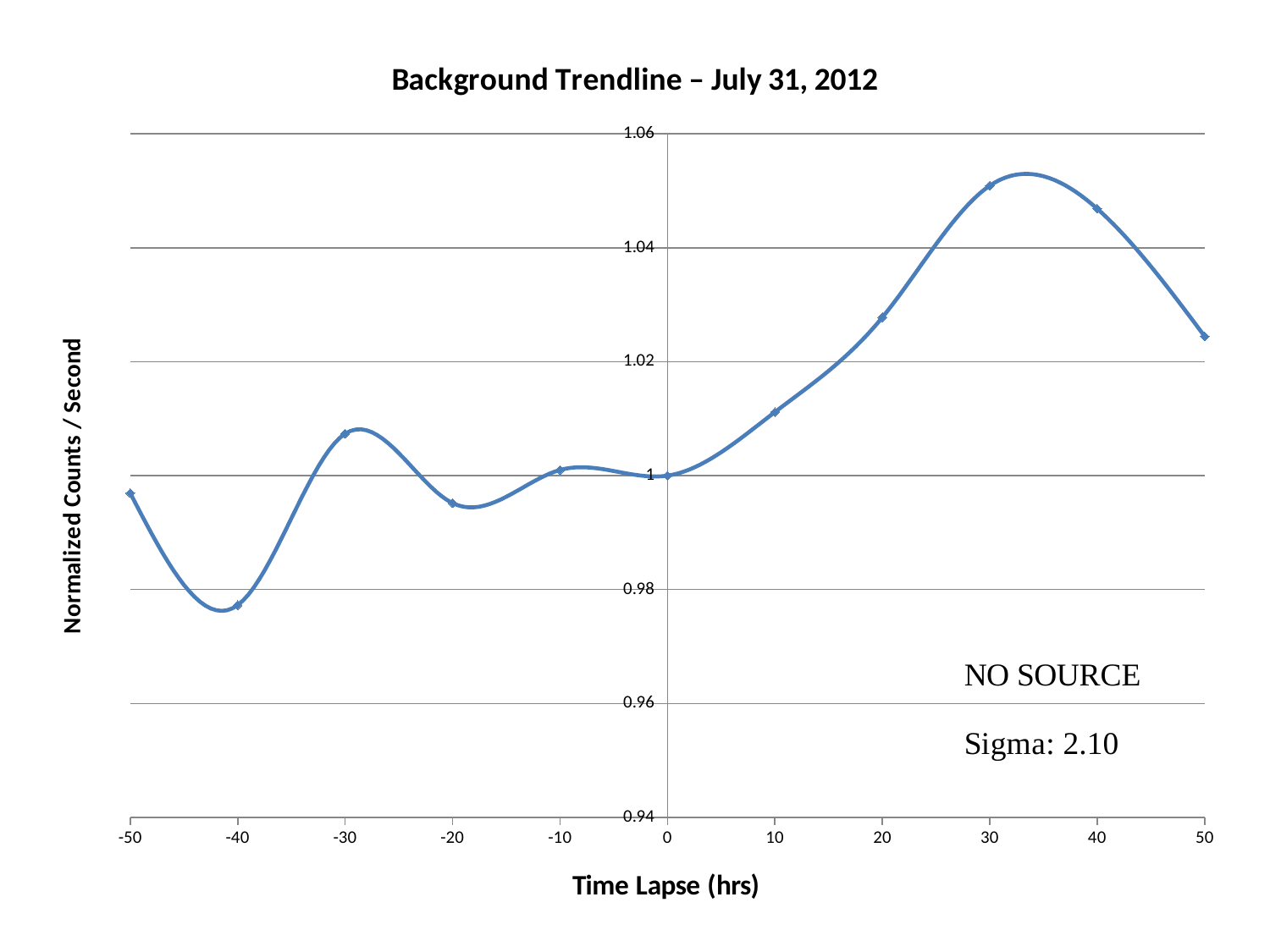
What is the normalized counts per second value at a time lapse of 0 hrs? 1 Is the value at a time lapse of 20 hrs greater or less than 1.02? greater At which time lapse is the normalized counts per second lowest? -40 What kind of chart is shown on the slide? line chart What is the label of the y axis? Normalized Counts / Second Which has the higher value, the point at -30 hrs or the point at -20 hrs? -30 hrs At which time lapse is the normalized counts per second highest? 30 How many data points are plotted on the line? 11 Between a time lapse of 0 hrs and 30 hrs, do the values rise or fall? rise Is the value at a time lapse of -40 hrs greater or less than 0.98? less What is the title of the chart? Background Trendline – July 31, 2012 Is the value at a time lapse of 30 hrs greater or less than 1.04? greater